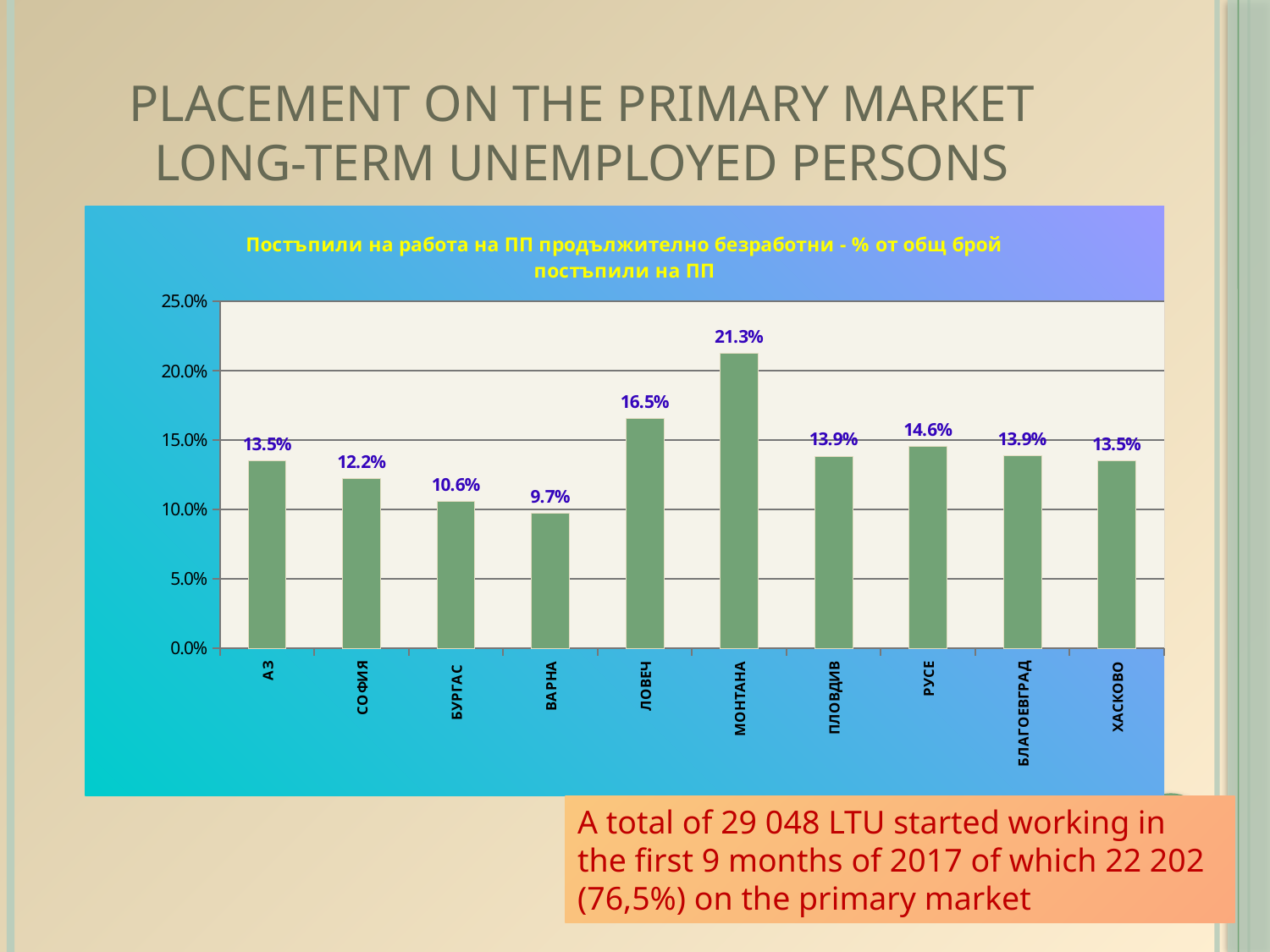
What is the value for АЗ? 13.5% What is the value for ВАРНА? 9.7% Which category has the lowest value? ВАРНА How many categories are shown on the x axis? 10 What is the value for РУСЕ? 14.6% What is the difference between the values for МОНТАНА and ВАРНА? 11.6% Which category has the highest value? МОНТАНА Which is larger, the value for СОФИЯ or the value for БУРГАС? СОФИЯ What is the value for ЛОВЕЧ? 16.5% Is the value for ЛОВЕЧ greater or less than 15.0%? greater What is the value for МОНТАНА? 21.3% What kind of chart is shown on the slide? bar chart